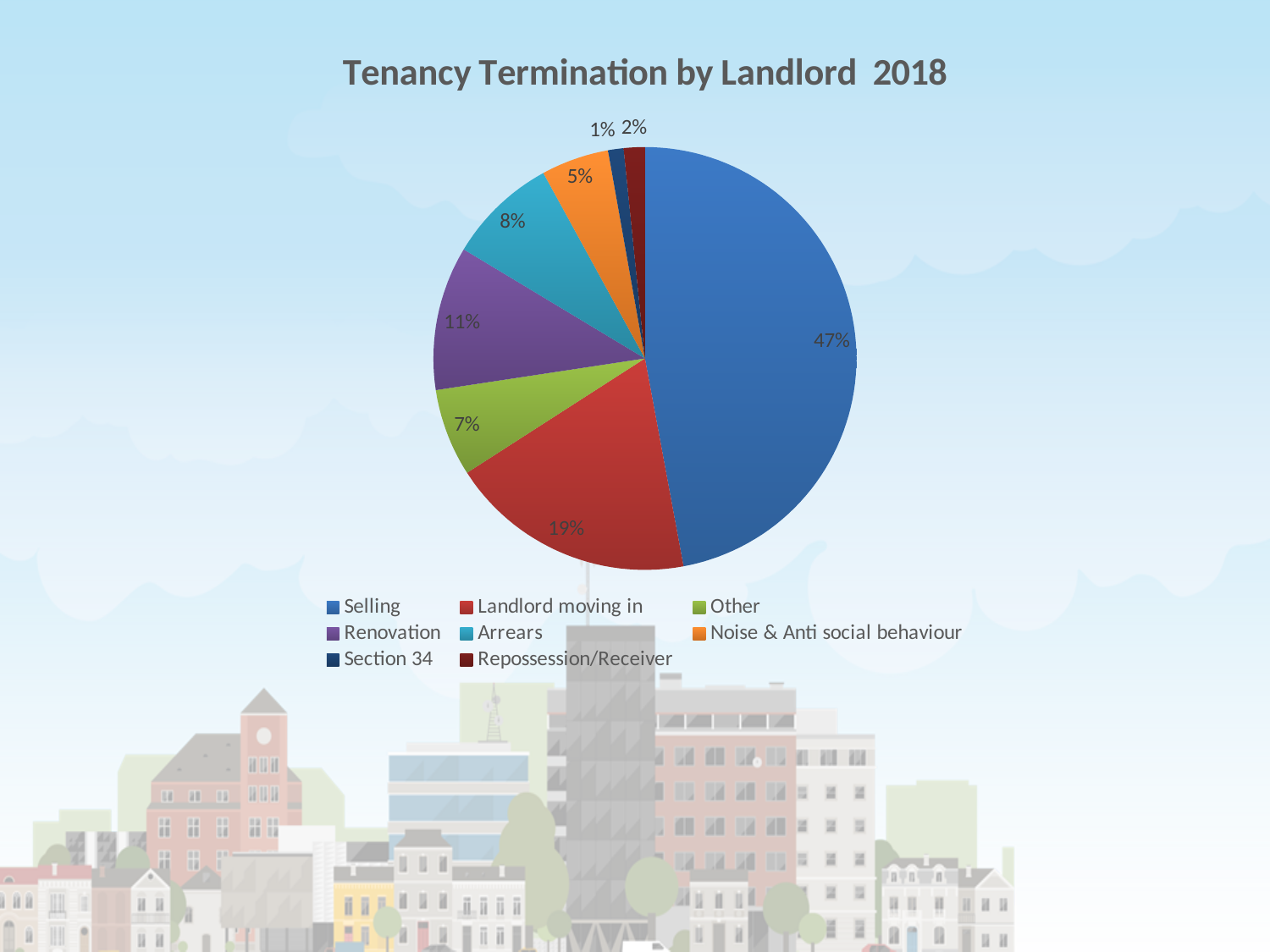
What percentage is shown for Noise & Anti social behaviour? 5% What percentage is shown for Arrears? 8% Which category has the smallest share of the pie? Section 34 How many categories does the pie chart show? 8 What share of the pie does Selling account for? 47% Which is larger, the share for Renovation or the share for Arrears? Renovation Which category has the largest share of the pie? Selling What percentage is shown for Renovation? 11% What type of chart is shown on the slide? Pie chart What is the title of the chart? Tenancy Termination by Landlord 2018 What percentage is shown for Landlord moving in? 19% What is the difference in percentage points between Selling and Landlord moving in? 28